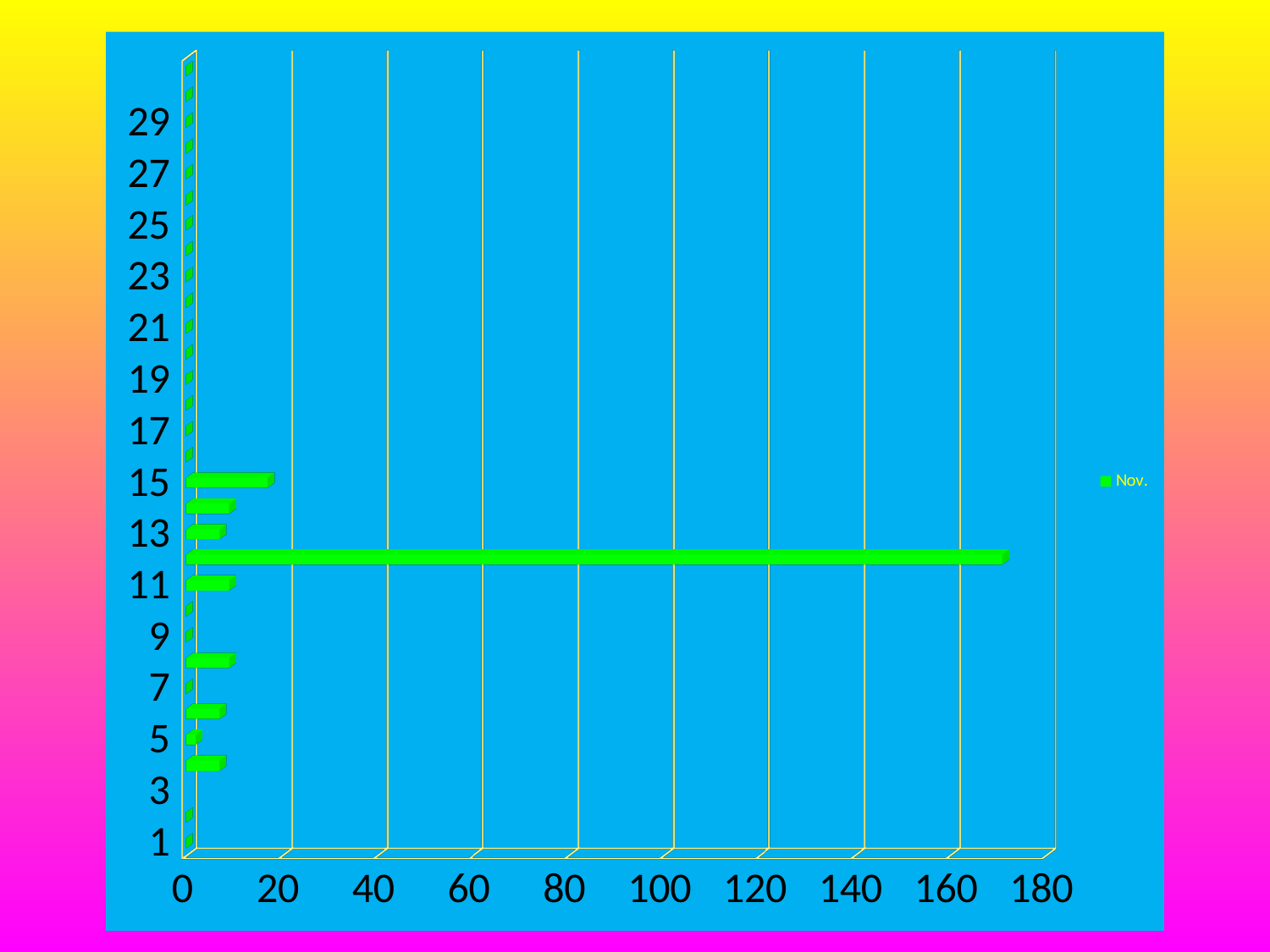
Which is larger, the value for category 12 or the value for category 15? 12 Which category has the highest value? 12 Is the value for category 12 greater or less than 180? less What is the name of the series shown in the legend? Nov. Which is larger, the value for category 15 or the value for category 13? 15 What is the highest value shown on the horizontal axis? 180 How many series does the legend list? 1 Is the value for category 12 greater or less than 160? greater What kind of chart is shown on the slide? bar chart Is the value for category 14 greater or less than 20? less Which is larger, the value for category 4 or the value for category 5? 4